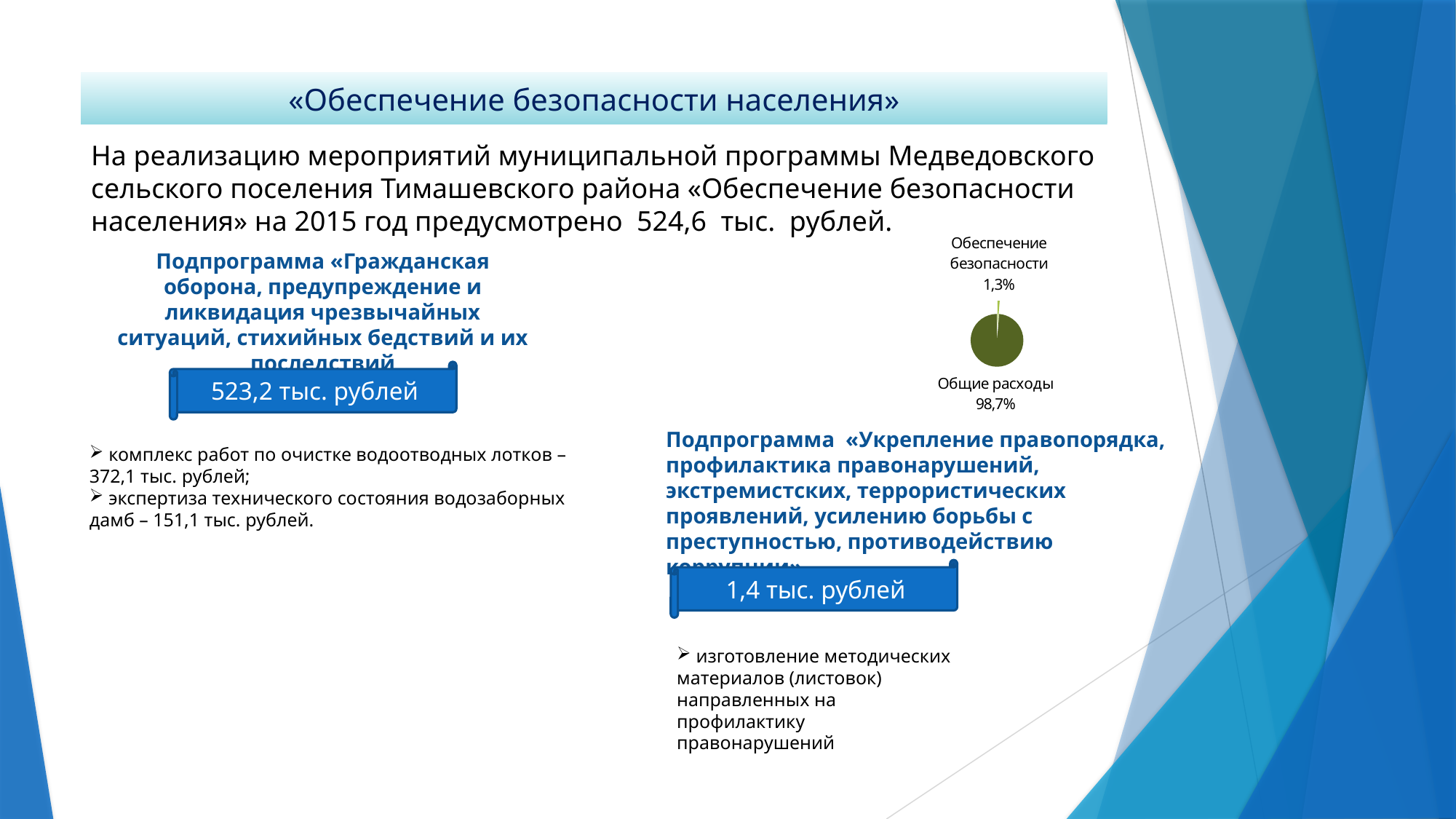
What colour is the large «Общие расходы» slice of the pie chart? dark olive green Is the share of «Общие расходы» in the pie chart greater or less than 50%? greater What share of the pie chart does «Общие расходы» take? 98,7% Is the share of «Обеспечение безопасности» in the pie chart greater or less than 10%? less How many slices does the pie chart have? 2 What kind of chart is shown on the slide? pie chart What share of the pie chart does «Обеспечение безопасности» take? 1,3% What is the difference in percentage points between the «Общие расходы» slice and the «Обеспечение безопасности» slice? 97,4% Which slice of the pie chart is the smallest? Обеспечение безопасности Which slice of the pie chart is the largest? Общие расходы Which is larger in the pie chart: «Общие расходы» or «Обеспечение безопасности»? Общие расходы What is the total of the two slice percentages shown on the pie chart? 100%